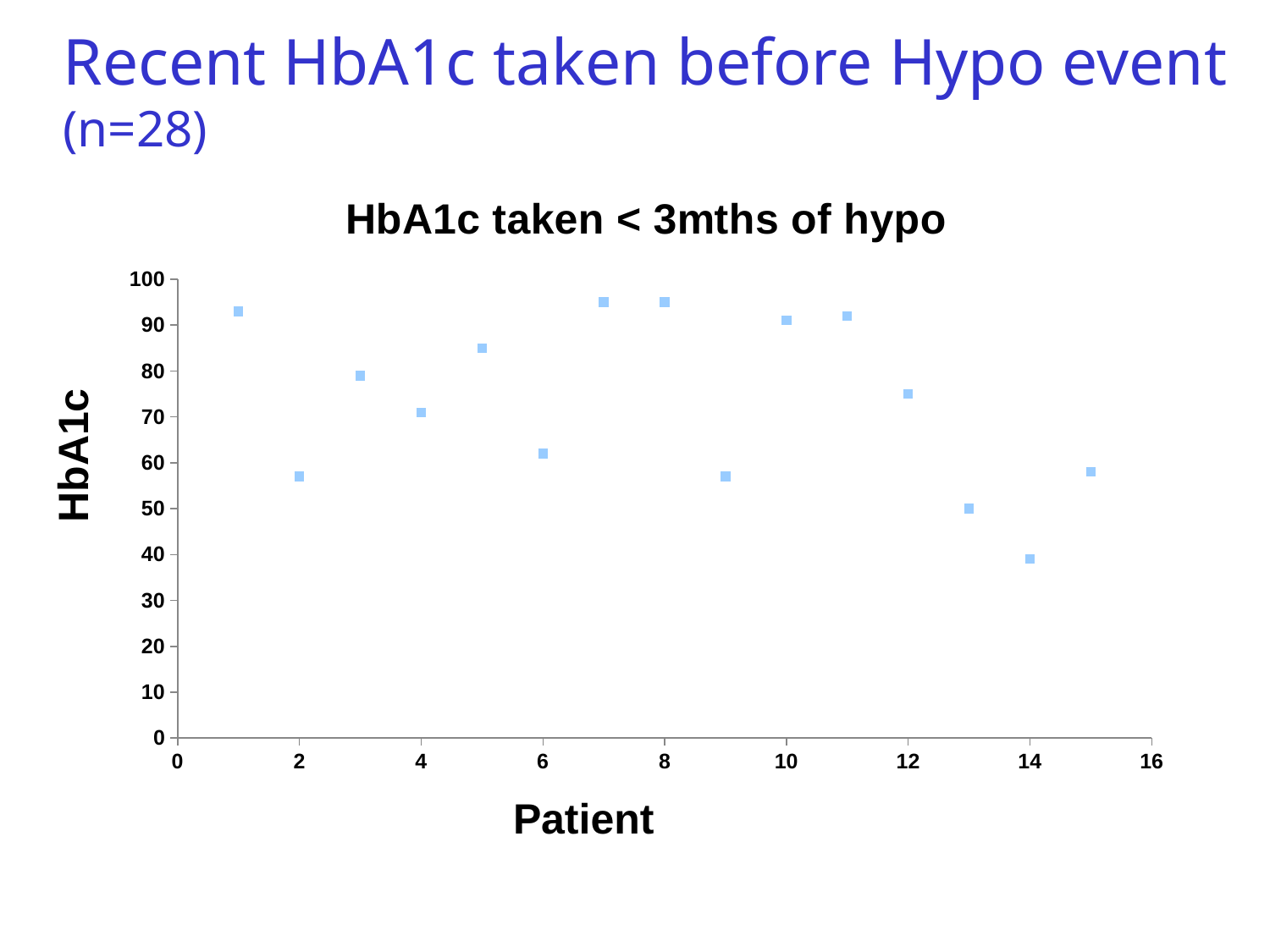
Which patient has the lowest HbA1c value on the chart? Patient 14 What kind of chart is shown on the slide? Scatter chart Which has the higher HbA1c value, patient 1 or patient 2? Patient 1 Is the HbA1c value for patient 5 greater or less than 80? greater Is the HbA1c value for patient 1 greater or less than 90? greater Which has the higher HbA1c value, patient 13 or patient 12? Patient 12 Is the HbA1c value for patient 14 greater or less than 50? less What is the title of the chart? HbA1c taken < 3mths of hypo How many data points are plotted on the chart? 15 What is the label of the horizontal axis? Patient